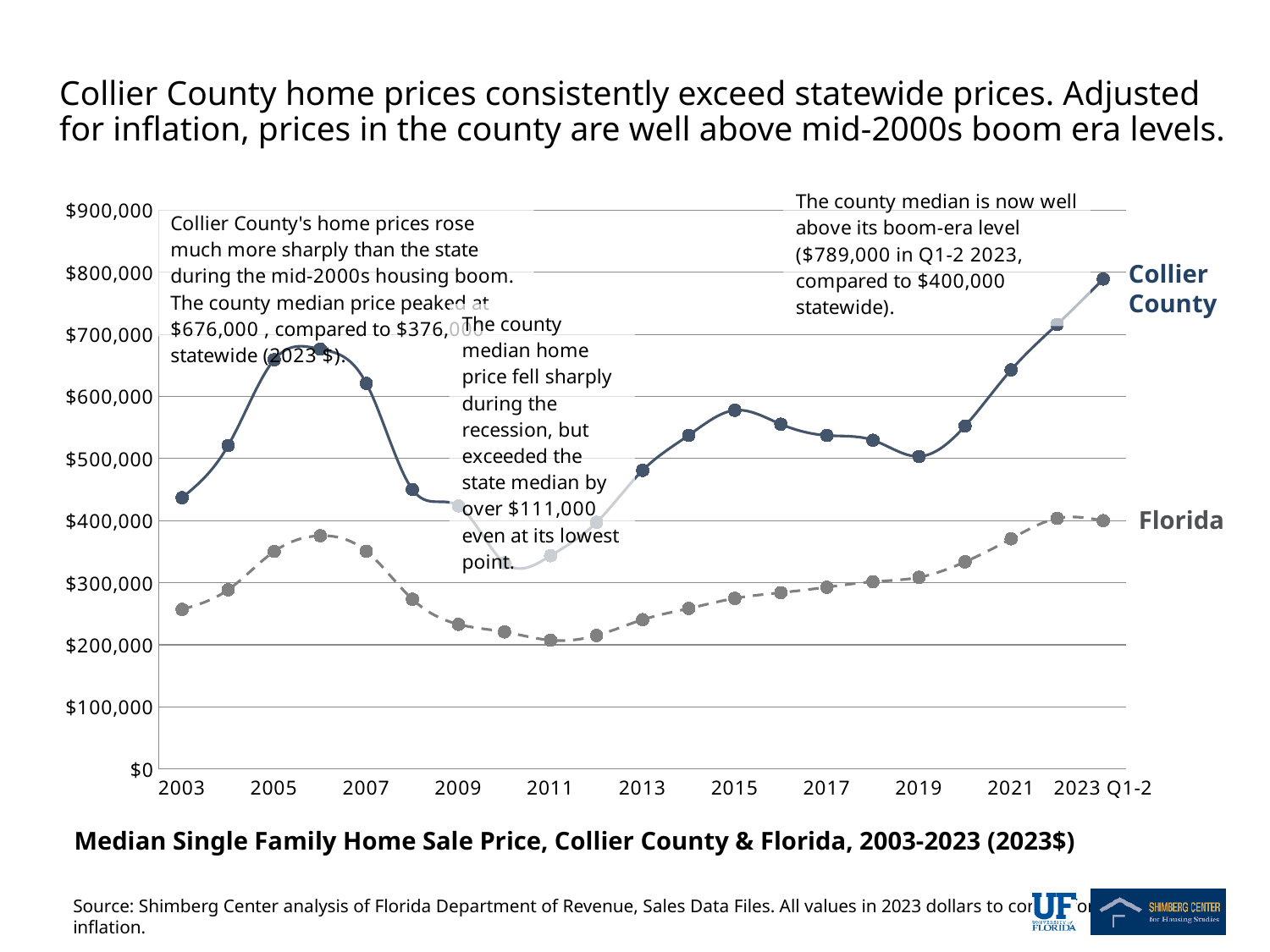
What is the difference between the Collier County boom-era peak ($676,000) and the statewide value at that time ($376,000)? $300,000 How many series does the chart plot? 2 Is the Florida value for 2011 greater or less than $300,000? less Does the Collier County line rise or fall between 2019 and 2023 Q1-2? Rise What is the title of the chart? Median Single Family Home Sale Price, Collier County & Florida, 2003-2023 (2023$) What type of chart is shown on the slide? Line chart According to the chart annotation, at what value did the Collier County median price peak during the mid-2000s boom? $676,000 Which series is higher in 2023 Q1-2, Collier County or Florida? Collier County According to the chart annotation, what was the statewide Florida median price in Q1-2 2023? $400,000 Is the Collier County value for 2003 greater or less than $400,000? greater What is the difference between the Collier County and Florida median prices in Q1-2 2023, using the values printed on the chart? $389,000 According to the chart annotation, what was the Collier County median price in Q1-2 2023? $789,000